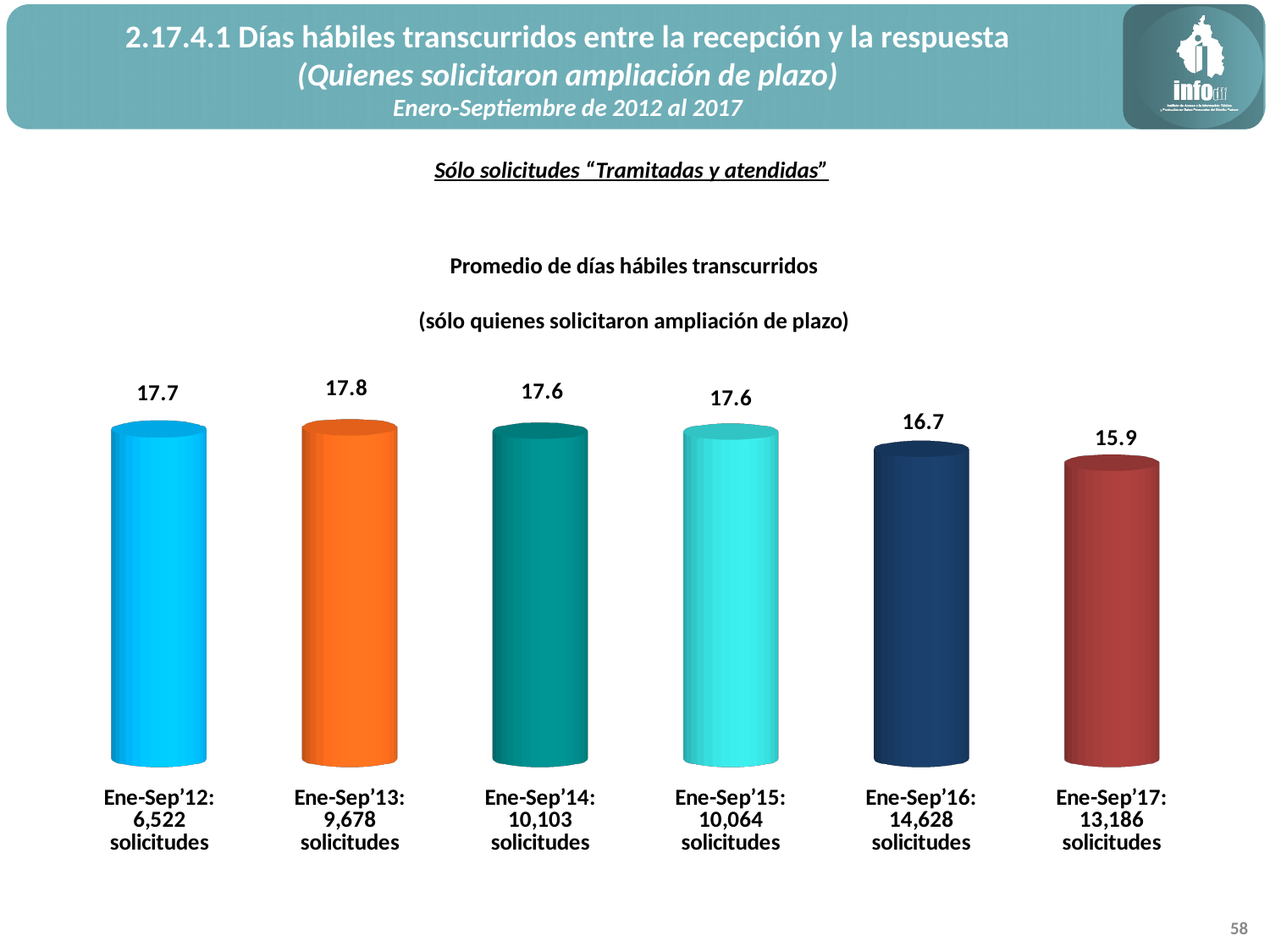
What is the average number of business days for Ene-Sep'16? 16.7 Do the values rise or fall from Ene-Sep'15 to Ene-Sep'17? Fall What is the difference between the values for Ene-Sep'13 and Ene-Sep'17? 1.9 Which period has the highest average number of business days? Ene-Sep'13 How many solicitudes are indicated for Ene-Sep'16 in the category label? 14,628 How many periods are shown in the chart? 6 What is the average number of business days for Ene-Sep'12? 17.7 What kind of chart is shown on the slide? Bar chart What is the average number of business days for Ene-Sep'17? 15.9 What is the difference between the values for Ene-Sep'12 and Ene-Sep'16? 1.0 Which period has the lowest average number of business days? Ene-Sep'17 Which is larger, the value for Ene-Sep'15 or the value for Ene-Sep'16? Ene-Sep'15